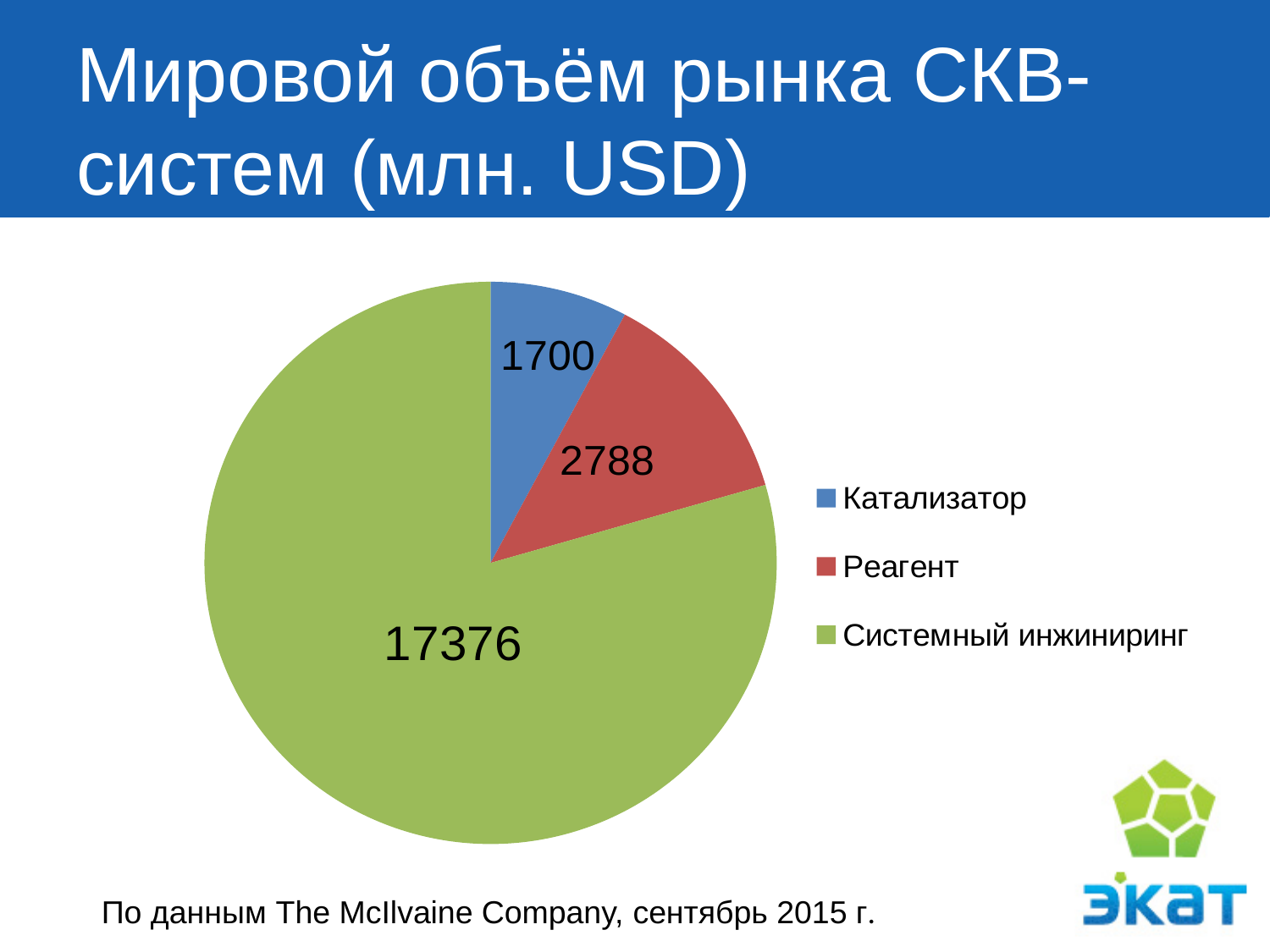
What is the total of all slices in the pie chart? 21864 Which category has the largest slice of the pie? Системный инжиниринг What is the value for Системный инжиниринг? 17376 What is the value for Катализатор? 1700 What is the difference between the values for Реагент and Катализатор? 1088 What is the value for Реагент? 2788 Which is larger, the value for Реагент or the value for Катализатор? Реагент What colour is the slice for Системный инжиниринг? Green How many categories does the pie chart show? 3 What type of chart is shown on the slide? Pie chart What is the difference between the values for Системный инжиниринг and Реагент? 14588 Which category has the smallest slice of the pie? Катализатор